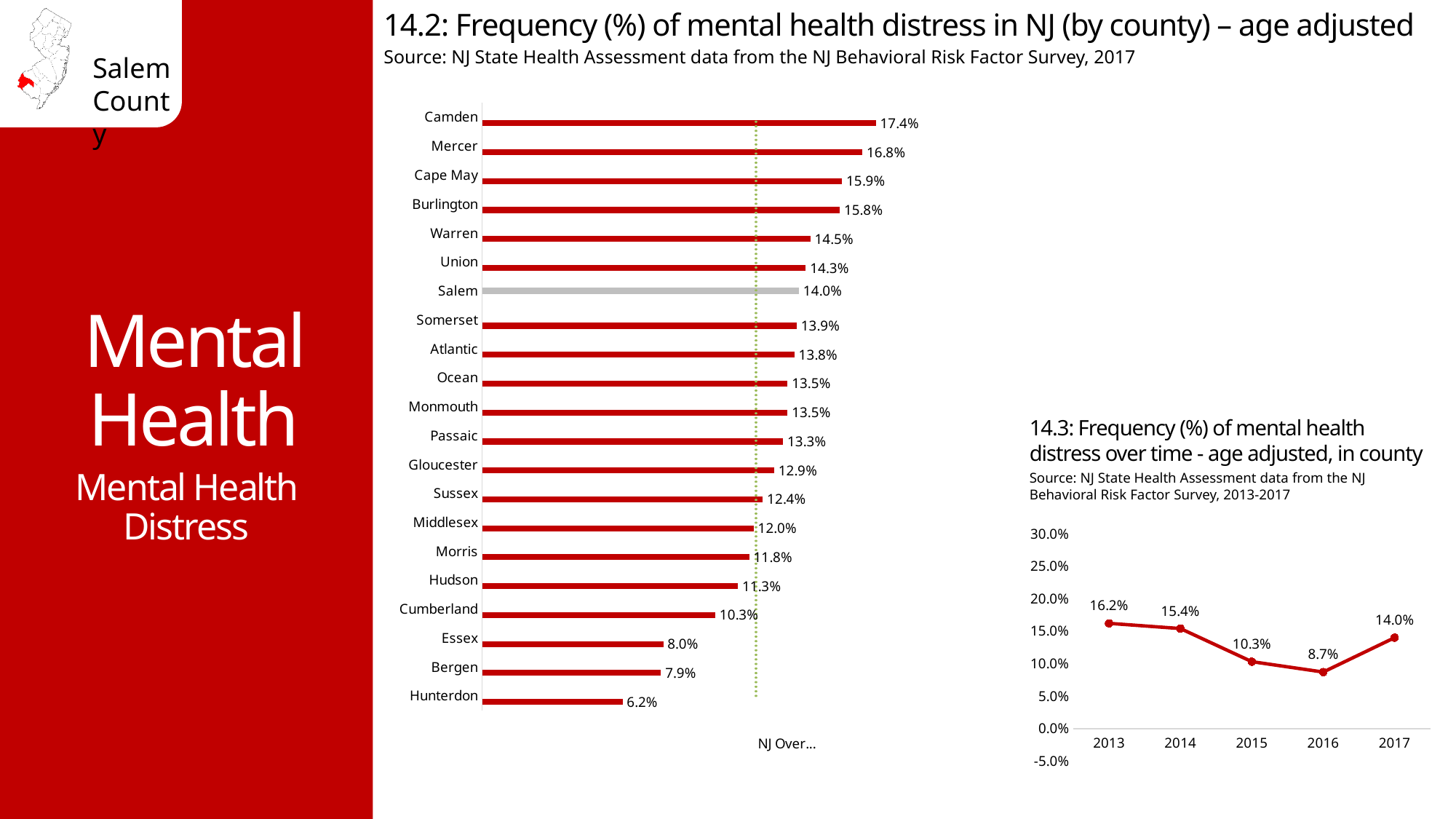
In chart 14.2, what is the value for Cumberland? 10.3% In chart 14.2, what is the frequency of mental health distress for Salem County? 14.0% In chart 14.2, which county has a higher value, Warren or Gloucester? Warren In chart 14.2, how many counties are shown? 21 In chart 14.3, which year has the highest value? 2013 In chart 14.2, which county has the highest frequency of mental health distress? Camden In chart 14.3, how many years are plotted? 5 In chart 14.3, what was the frequency of mental health distress in 2016? 8.7% In chart 14.2, which county has the lowest frequency of mental health distress? Hunterdon In chart 14.2, what is the difference between the values for Camden and Hunterdon? 11.2% In chart 14.3, what is the difference between the 2013 and 2017 values? 2.2% What kind of chart is chart 14.2? Bar chart